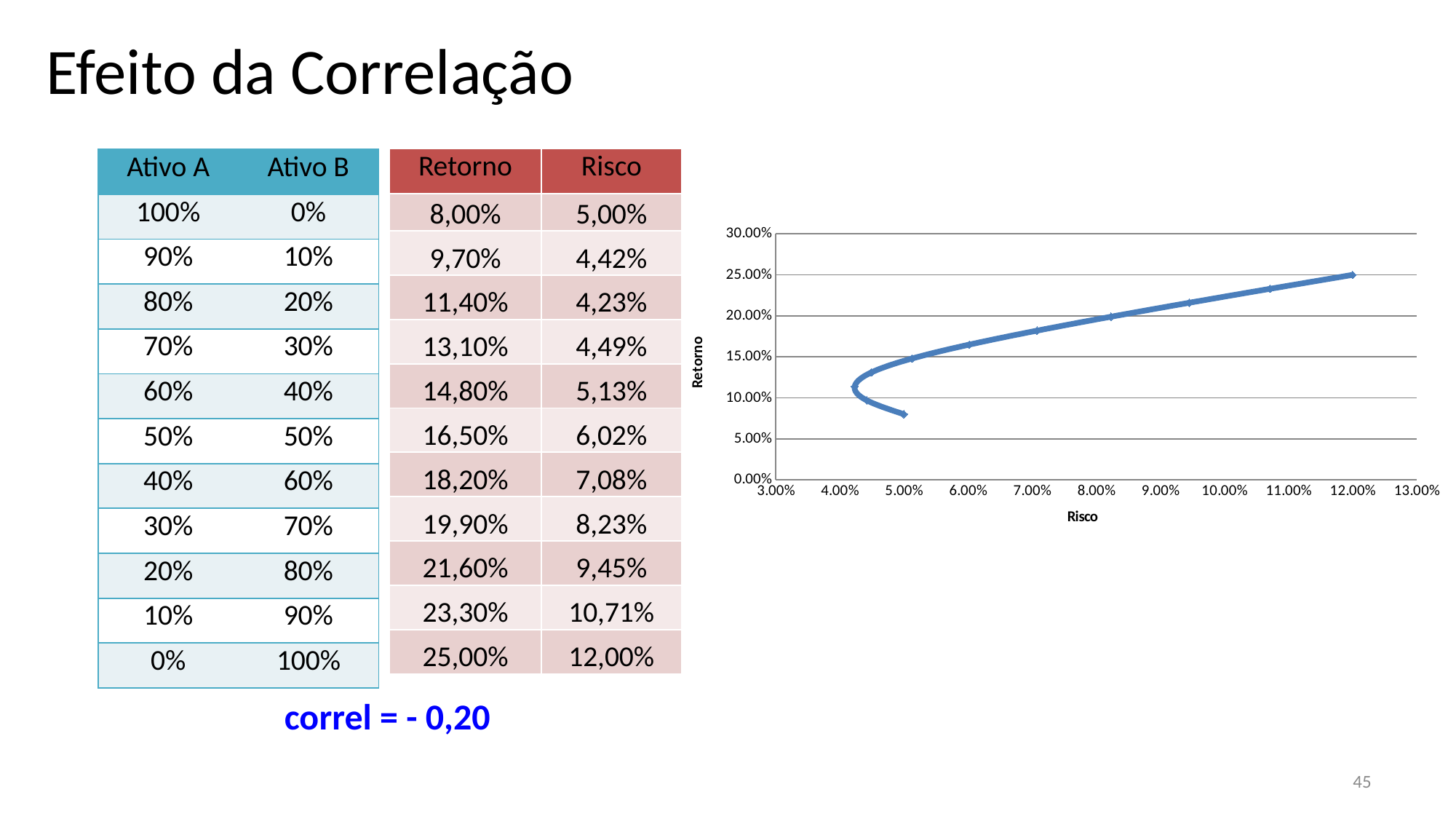
What is the Risco value of the point with the lowest Retorno on the chart? 5.00% How many data points are plotted on the chart? 11 Is the lowest Risco value plotted on the chart greater or less than 5.00%? less What is the title of the vertical axis of the chart? Retorno What kind of chart is shown on the slide? scatter chart with a smoothed line What is the Retorno value of the point with the highest Risco on the chart? 25.00% Is the Retorno of the lowest point on the chart greater or less than 10.00%? less What is the title of the horizontal axis of the chart? Risco Is the Retorno of the highest point on the chart greater or less than 20.00%? greater What is the Risco value of the point with the highest Retorno on the chart? 12.00% Which point has the higher Retorno: the one at Risco 12.00% or the one at Risco 5.00%? the one at Risco 12.00% As Risco increases from 5.00% to 12.00% along the curve, does Retorno rise or fall? rise